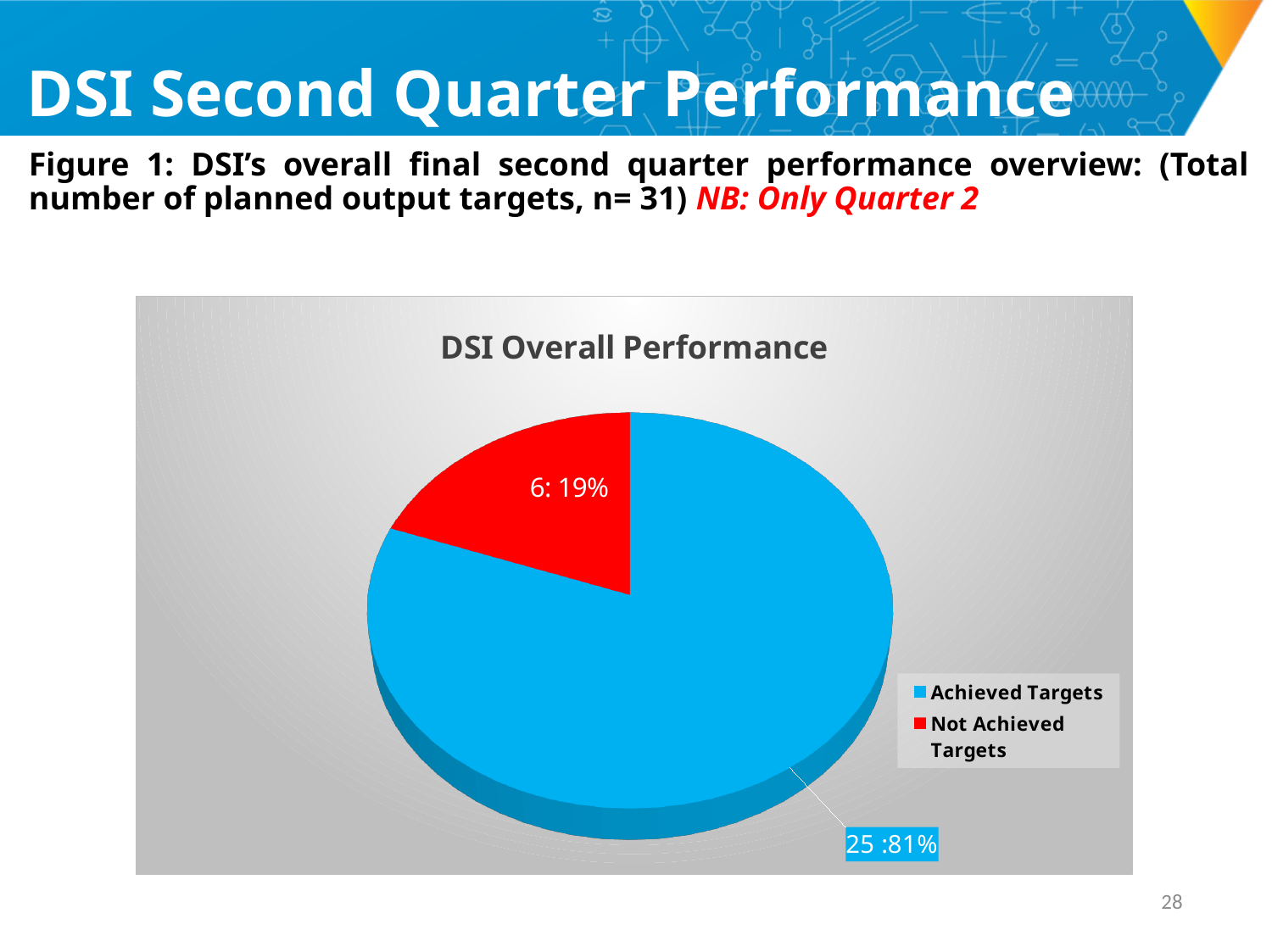
How many entries does the legend list? 2 How many targets were not achieved according to the chart? 6 How many slices does the pie chart have? 2 Which slice is the largest? Achieved Targets Which slice is the smallest? Not Achieved Targets How many targets were achieved according to the chart? 25 Which colour represents Not Achieved Targets? red What kind of chart is shown on the slide? pie chart What percentage of the pie is Achieved Targets? 81% What is the title of the chart? DSI Overall Performance What is the difference between the number of achieved and not achieved targets? 19 What percentage of the pie is Not Achieved Targets? 19%